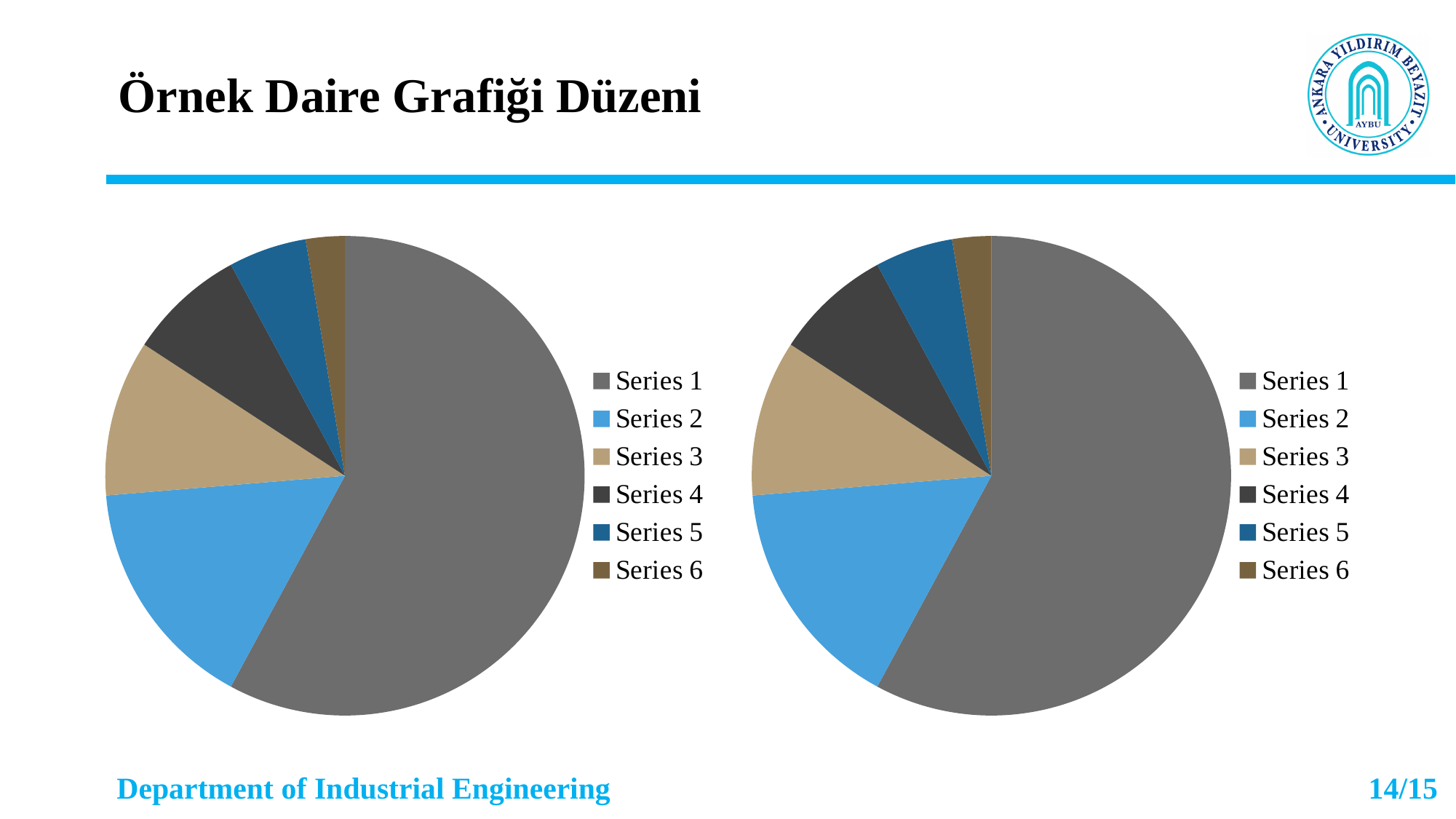
What colour is the Series 2 slice in the left pie chart? Blue In the left pie chart, which slice is larger, Series 3 or Series 6? Series 3 How many slices does the right pie chart have? 6 In the right pie chart, which slice is larger, Series 4 or Series 5? Series 4 What is the first entry listed in the legend of the right pie chart? Series 1 How many series does the legend of the left pie chart list? 6 In the left pie chart, which slice is larger, Series 2 or Series 3? Series 2 In the left pie chart, which series has the largest slice? Series 1 In the right pie chart, which series has the largest slice? Series 1 What kind of chart is the left chart on the slide? Pie chart What kind of chart is the right chart on the slide? Pie chart